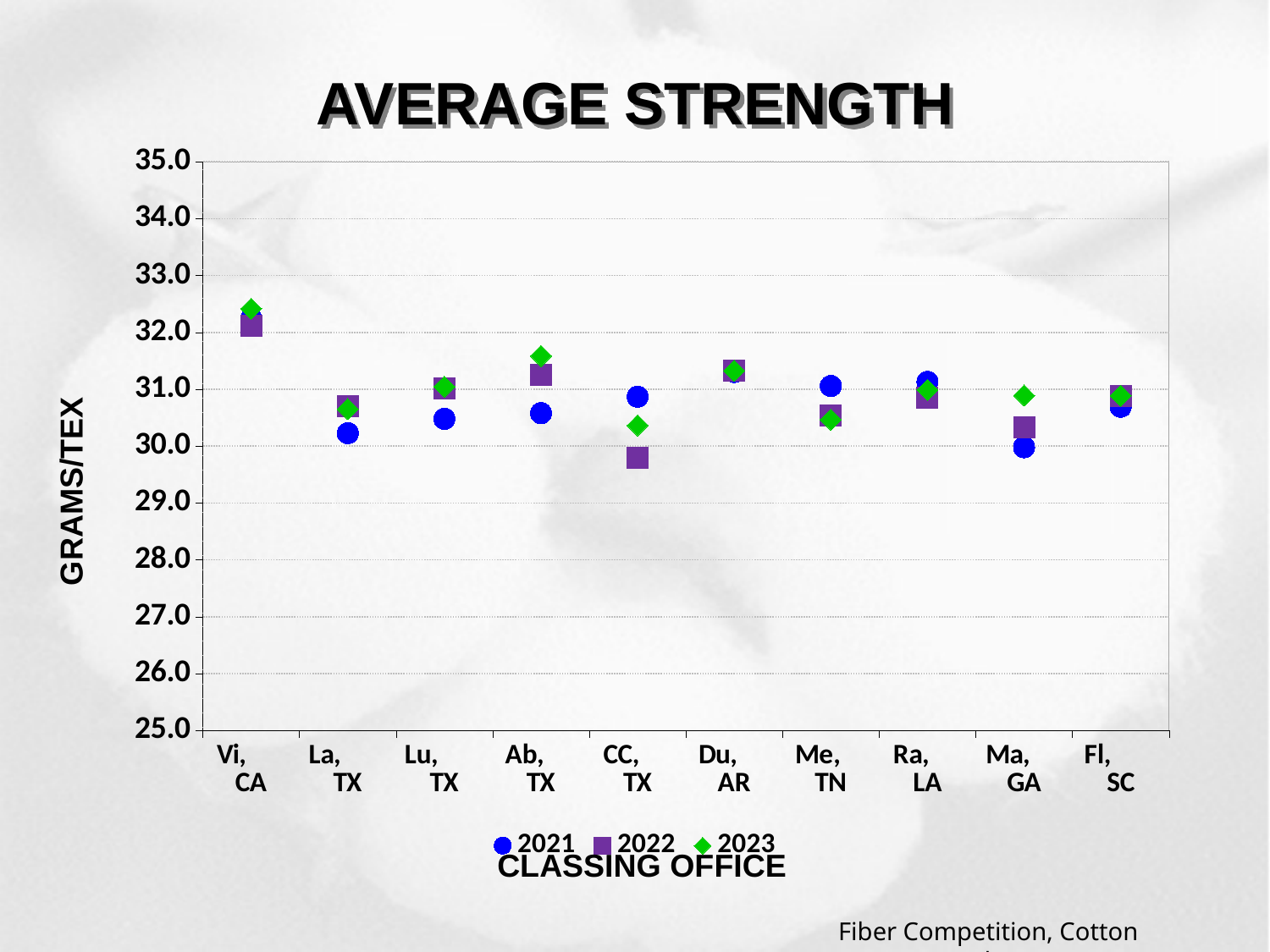
What is the title of the y axis? GRAMS/TEX What kind of chart is shown on the slide? scatter chart Is the 2023 value for Vi, CA greater or less than 32.0? greater For Ab, TX, which is larger: the 2021 value or the 2023 value? 2023 Which classing office has the highest 2023 average strength? Vi, CA How many series does the legend list? 3 Is the 2022 value for CC, TX greater or less than 30.0? less How many classing offices are plotted along the x axis? 10 Which classing office has the lowest 2022 average strength? CC, TX For La, TX, which is larger: the 2021 value or the 2022 value? 2022 Is the 2021 value for Ma, GA greater or less than 31.0? less Which classing office has the highest 2021 average strength? Vi, CA